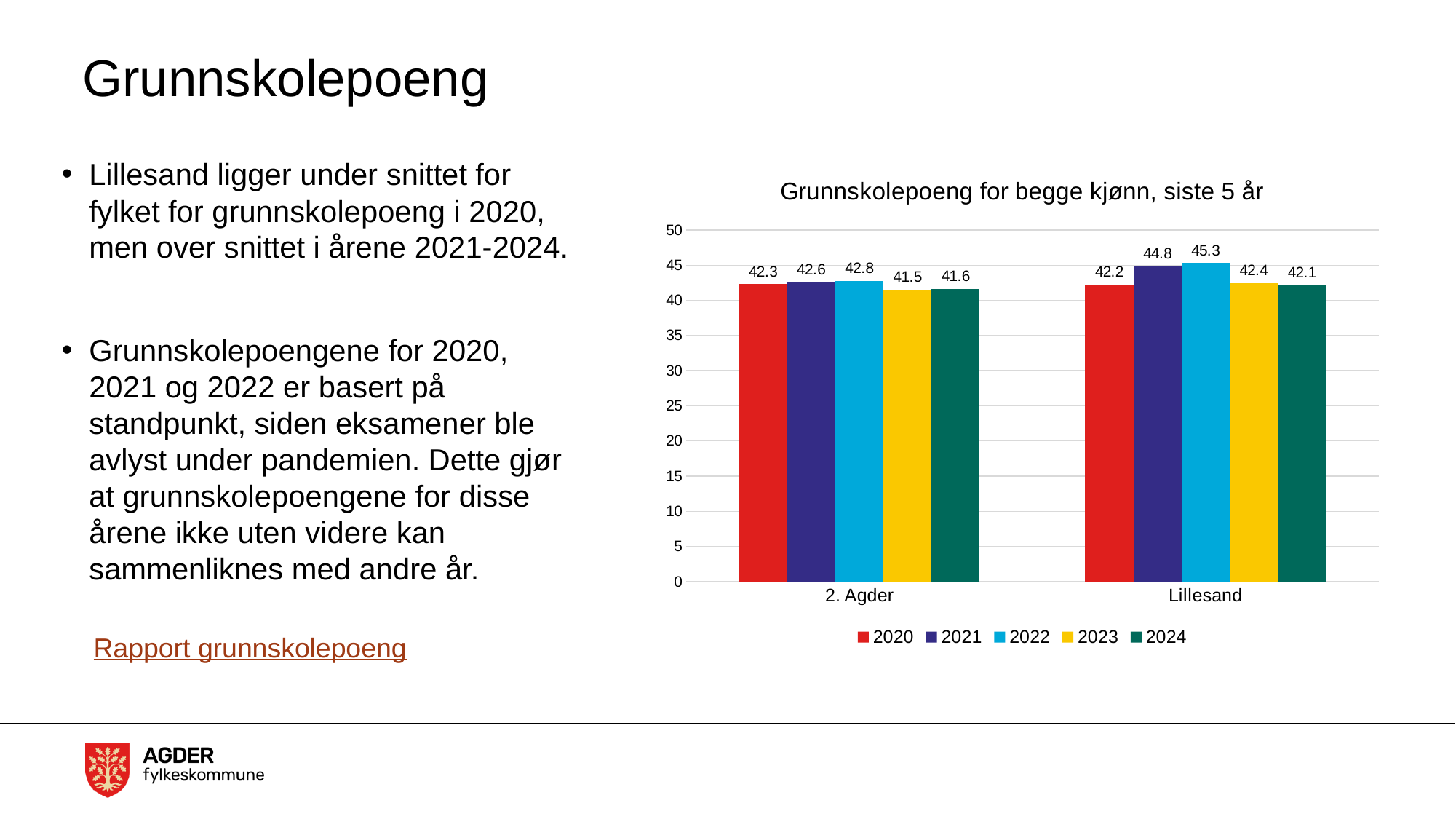
What is the value for 2. Agder in 2023? 41.5 Is the value for Lillesand in 2022 greater or less than 45? greater What is the value for Lillesand in 2022? 45.3 What is the title of the chart? Grunnskolepoeng for begge kjønn, siste 5 år How many series does the legend list? 5 How many categories are shown on the x axis? 2 Which year has the highest value for Lillesand? 2022 Which year has the lowest value for 2. Agder? 2023 What is the value for Lillesand in 2020? 42.2 Which is larger in 2024: 2. Agder or Lillesand? Lillesand What is the difference between Lillesand and 2. Agder in 2021? 2.2 What kind of chart is shown? bar chart